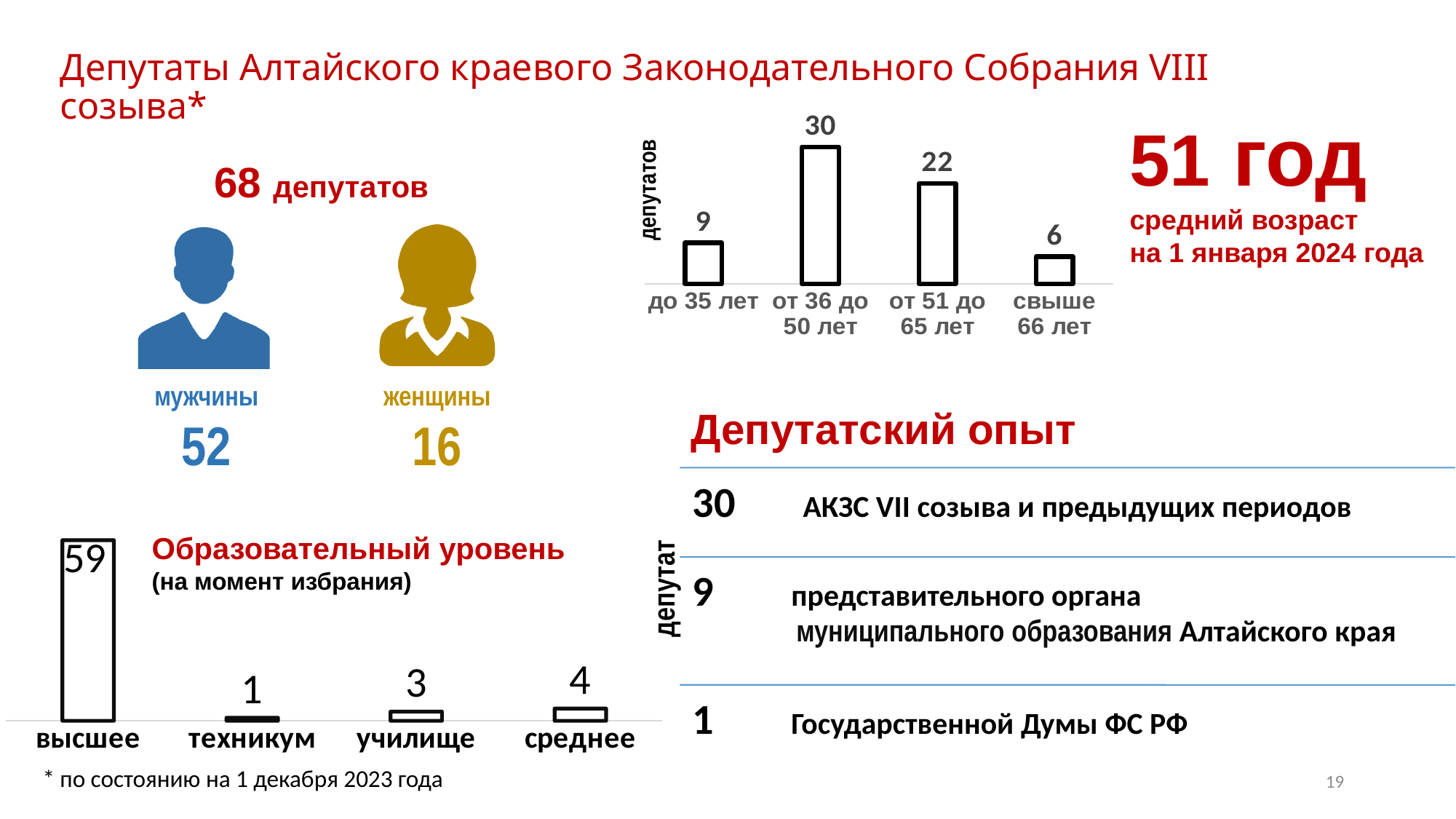
In the age distribution bar chart at the top right, which age category has the lowest value? свыше 66 лет What type of chart is the 'Образовательный уровень' chart at the bottom left? bar chart In the age distribution bar chart at the top right, how many deputies are in the 'от 36 до 50 лет' category? 30 In the 'Образовательный уровень' chart, what is the value for 'высшее'? 59 In the age distribution bar chart at the top right, which age category has the highest value? от 36 до 50 лет In the 'Образовательный уровень' chart, which category has the lowest value? техникум In the 'Образовательный уровень' chart, which is larger: 'училище' or 'среднее'? среднее In the age distribution bar chart at the top right, how many deputies are in the 'свыше 66 лет' category? 6 In the 'Образовательный уровень' chart, what is the value for 'училище'? 3 In the age distribution bar chart at the top right, how many age categories are shown? 4 In the age distribution bar chart at the top right, what is the difference between the 'от 36 до 50 лет' and 'от 51 до 65 лет' values? 8 In the 'Образовательный уровень' chart, what is the difference between 'высшее' and 'среднее'? 55